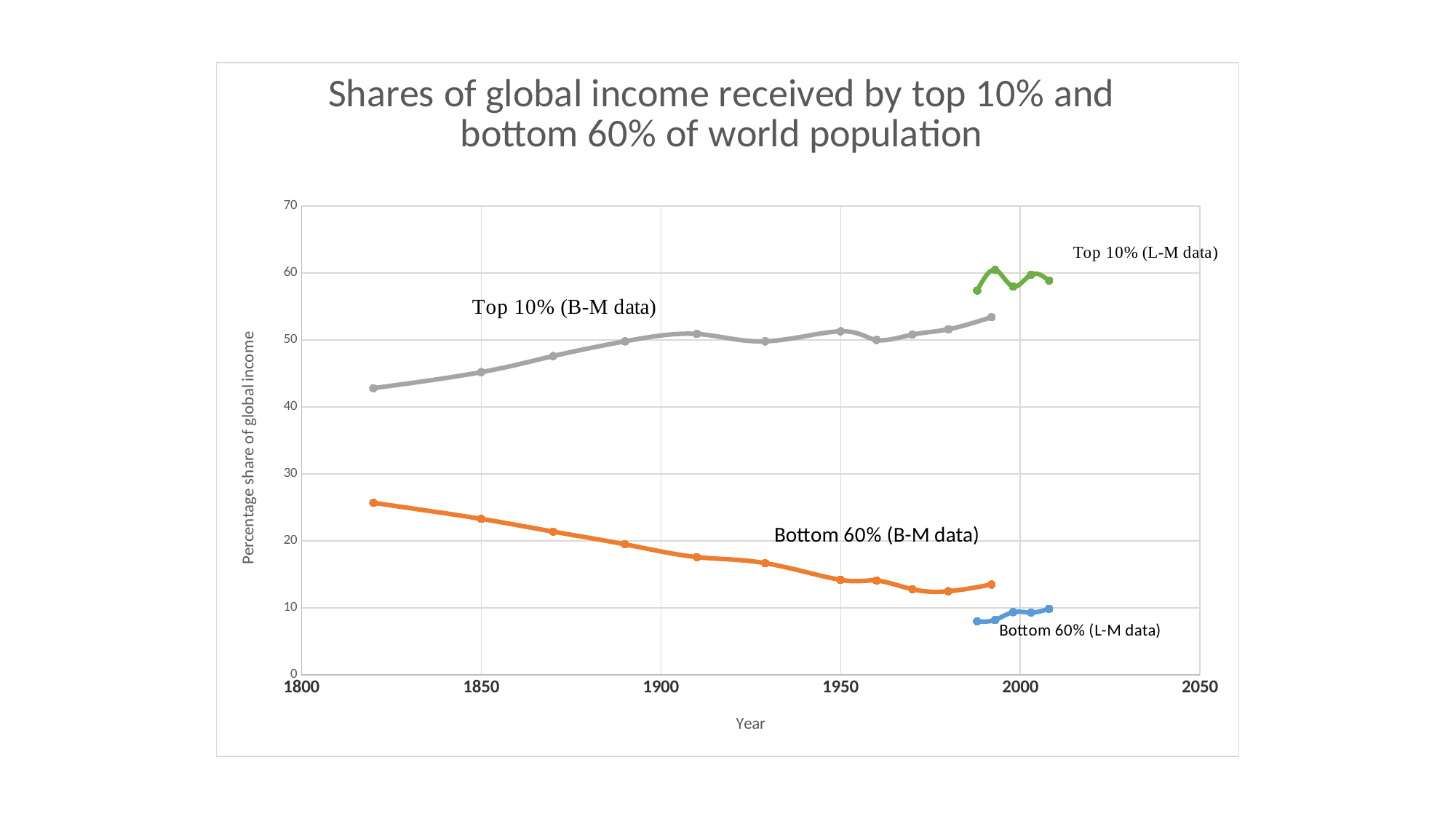
How many data series (lines) are plotted on the chart? 4 Is the first value of the Bottom 60% (L-M data) series greater or less than 10? less Does the Bottom 60% (B-M data) series rise or fall from 1820 to the 1990s? fall What kind of chart is shown on the slide? line chart Around 1990, which is larger: Top 10% (L-M data) or Top 10% (B-M data)? Top 10% (L-M data) What is the title of the chart? Shares of global income received by top 10% and bottom 60% of world population Is the value for Bottom 60% (B-M data) in 1820 greater or less than 30? less Is the value for Top 10% (B-M data) in 1820 greater or less than 40? greater What is the label on the vertical axis of the chart? Percentage share of global income Does the Top 10% (B-M data) series rise or fall overall from 1820 to the 1990s? rise Which series has the highest values on the chart? Top 10% (L-M data)